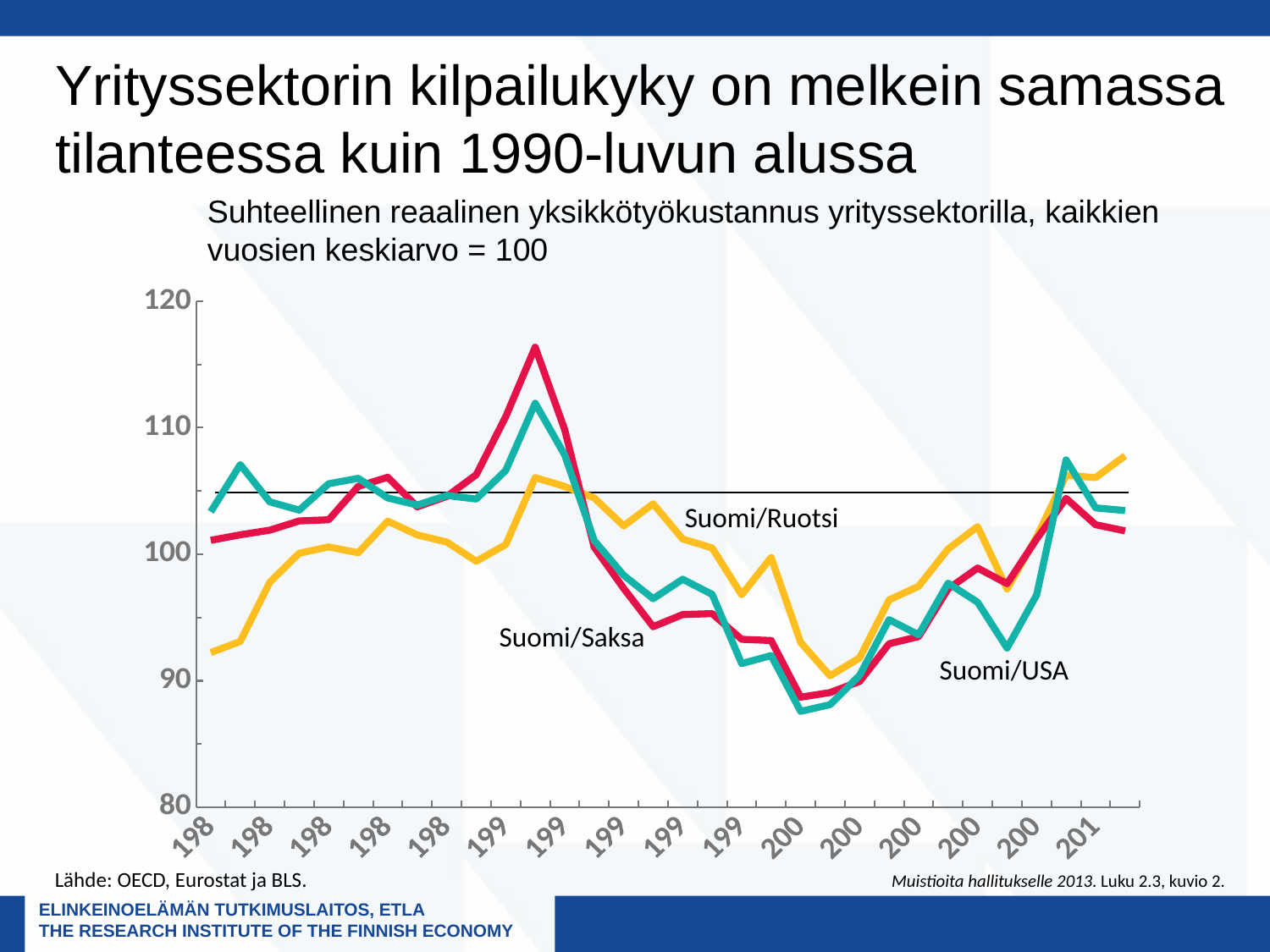
What kind of chart is shown on the slide? line chart Is the last plotted value of Suomi/Ruotsi greater or less than 100? greater Which series reaches the highest peak on the chart? Suomi/Saksa What is the highest value shown on the vertical axis? 120 Is the lowest value of Suomi/USA greater or less than 90? less Is the peak value of Suomi/Saksa greater or less than 110? greater How many series are plotted on the chart? 3 At the start of the chart, which is larger: the value for Suomi/USA or the value for Suomi/Ruotsi? Suomi/USA Which series is labelled in red on the chart? Suomi/Saksa Does the Suomi/Ruotsi series rise or fall over its first few points on the chart? rise